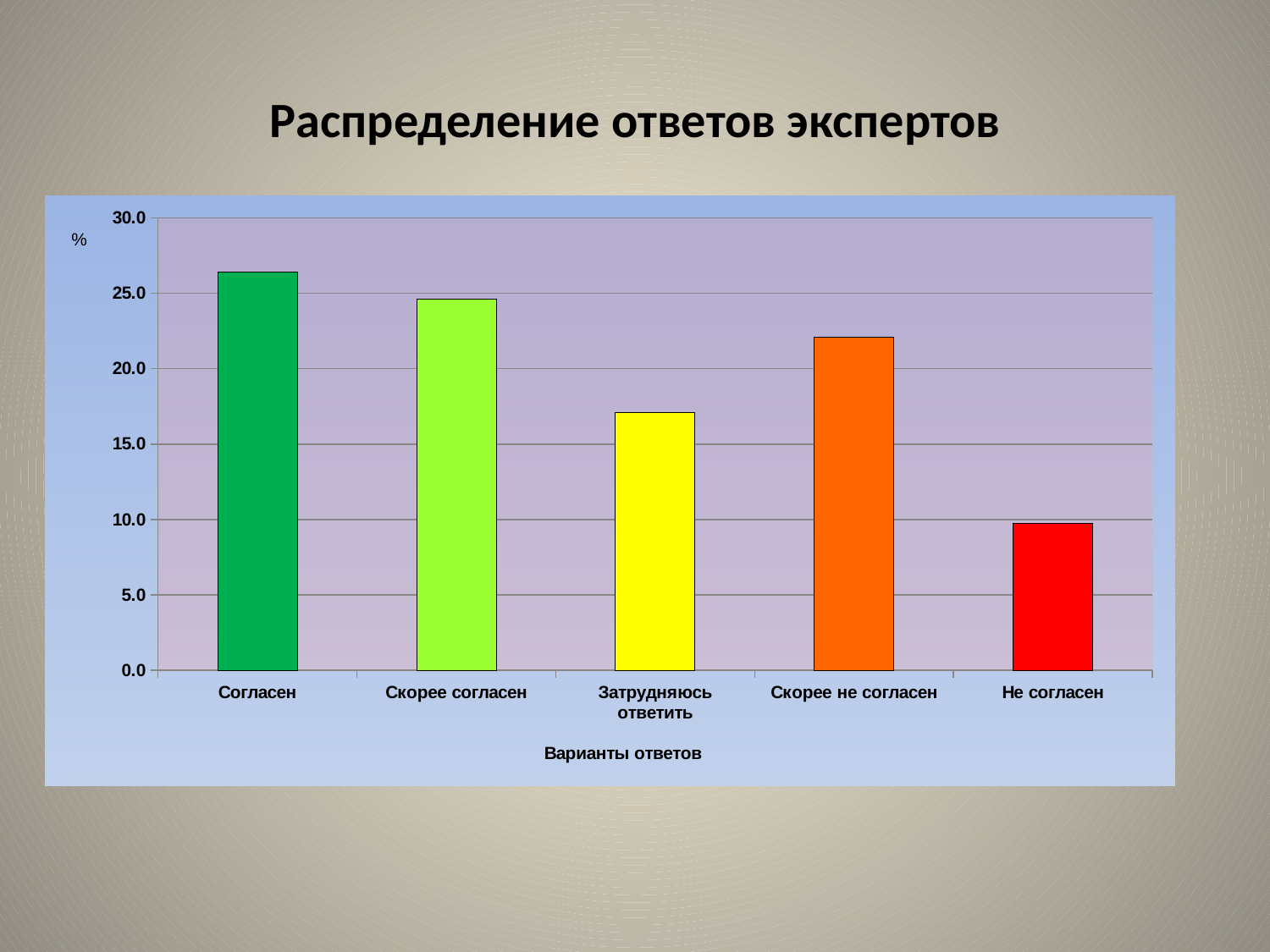
What is the label of the x axis? Варианты ответов Which answer option has the highest value? Согласен Which answer option has the lowest value? Не согласен What kind of chart is shown on the slide? bar chart What is the title of the chart? Распределение ответов экспертов Is the value for Затрудняюсь ответить greater or less than 15.0? greater How many answer categories are shown on the x axis? 5 Is the value for Не согласен greater or less than 15.0? less Is the value for Скорее не согласен greater or less than 20.0? greater Which is larger, the value for Скорее не согласен or the value for Затрудняюсь ответить? Скорее не согласен